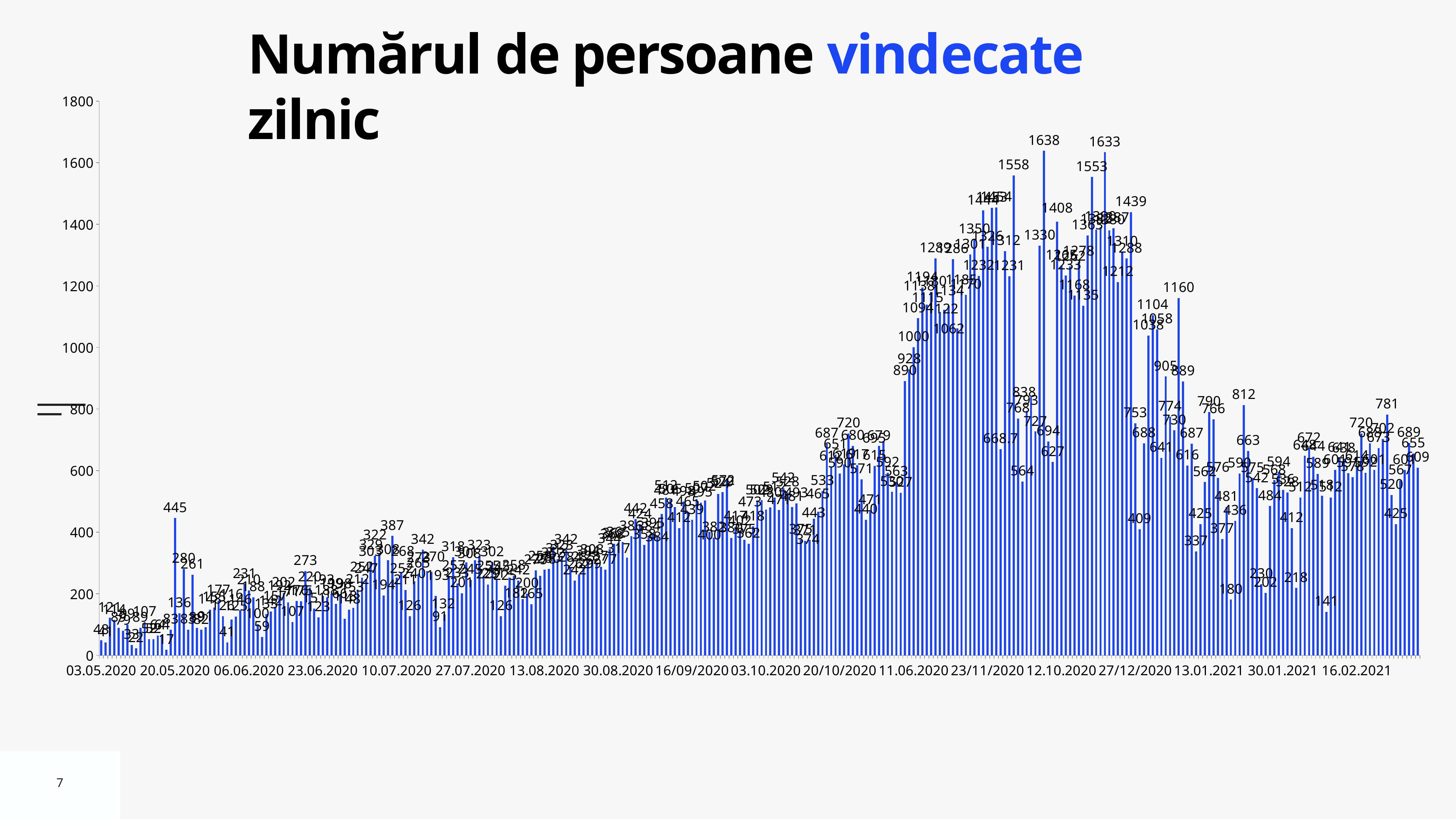
What is the highest daily value shown in the chart? 1638 Do the values generally rise or fall from May 2020 to December 2020? rise What is the difference between the highest value 1638 and the value 1558? 80 What is the title of the chart? Numărul de persoane vindecate zilnic Is the value of the first bar (03.05.2020) greater or less than 200? less What is the highest tick value on the vertical axis? 1800 What kind of chart is shown on the slide? bar chart What is the lowest daily value labelled in the chart? 17 Is the value of the tallest bar greater or less than 1600? greater Which is larger, the bar labelled 1638 or the bar labelled 1558? 1638 What is the difference between the two highest values, 1638 and 1633? 5 Is the value of the last bar on the right greater or less than 400? greater